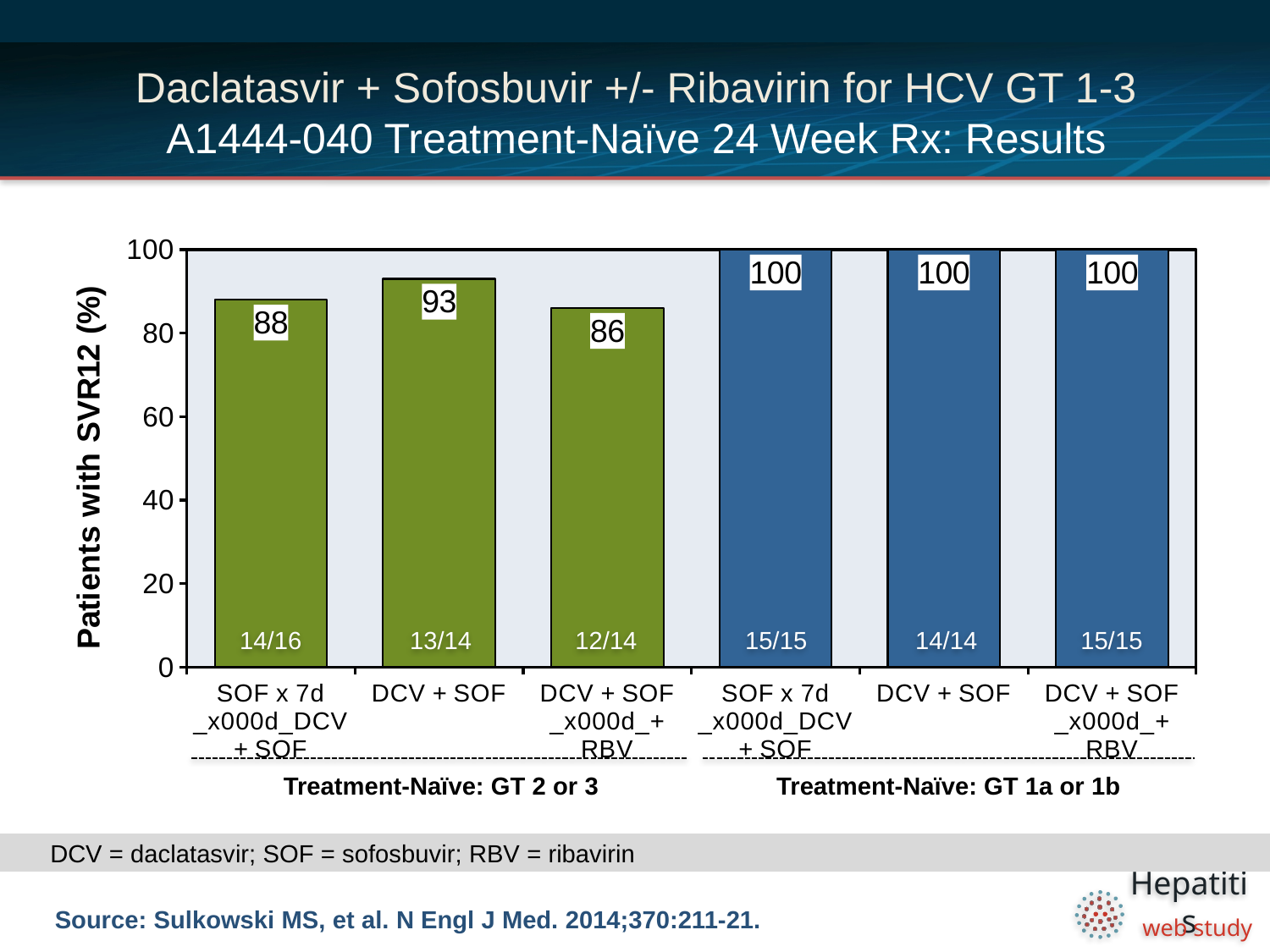
What is the label of the y-axis of the chart? Patients with SVR12 (%) Which has a higher SVR12 percentage: DCV + SOF in the GT 2 or 3 group or DCV + SOF in the GT 1a or 1b group? DCV + SOF in the GT 1a or 1b group How many patients achieved SVR12 out of the total for DCV + SOF in the Treatment-Naïve: GT 1a or 1b group? 14/14 What is the SVR12 percentage for DCV + SOF in the Treatment-Naïve: GT 2 or 3 group? 93 What is the SVR12 percentage for SOF x 7d then DCV + SOF in the Treatment-Naïve: GT 2 or 3 group? 88 Which regimen in the Treatment-Naïve: GT 2 or 3 group has the highest SVR12 percentage? DCV + SOF What is the SVR12 percentage for DCV + SOF + RBV in the Treatment-Naïve: GT 1a or 1b group? 100 What is the SVR12 percentage for DCV + SOF + RBV in the Treatment-Naïve: GT 2 or 3 group? 86 Which regimen in the Treatment-Naïve: GT 2 or 3 group has the lowest SVR12 percentage? DCV + SOF + RBV How many bars are shown in the chart? 6 What is the difference in SVR12 percentage between DCV + SOF and DCV + SOF + RBV in the Treatment-Naïve: GT 2 or 3 group? 7 What type of chart is shown on the slide? Bar chart